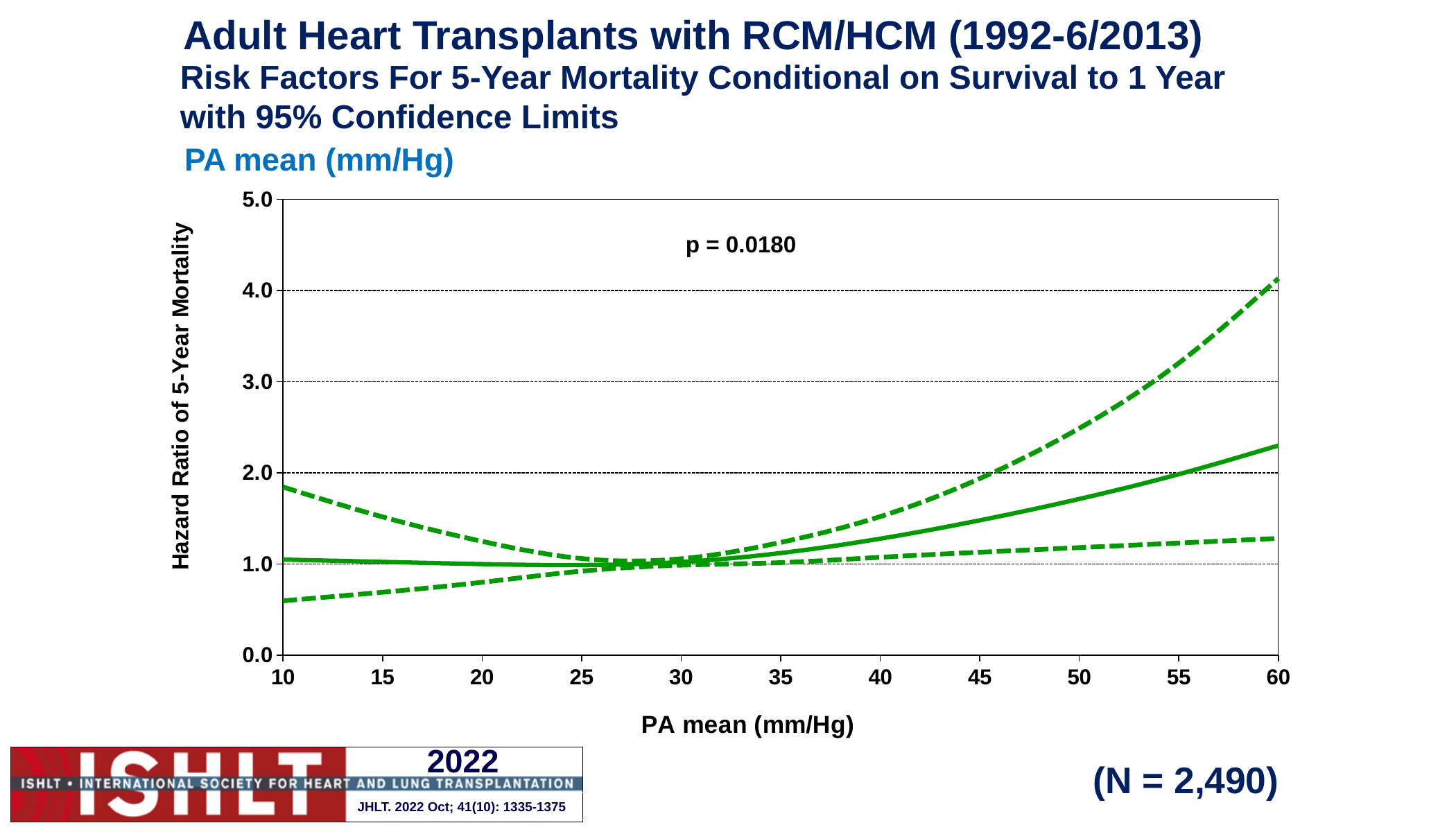
Which is larger on the solid line: the hazard ratio at a PA mean of 60 mm/Hg or at 10 mm/Hg? 60 mm/Hg Is the lower dashed confidence limit at a PA mean of 10 mm/Hg greater or less than 1.0? less Is the upper dashed confidence limit at a PA mean of 10 mm/Hg greater or less than 2.0? less What is the label of the y axis? Hazard Ratio of 5-Year Mortality How many lines are plotted on the chart? 3 What is the highest value shown on the x axis? 60 Is the hazard ratio on the solid line at a PA mean of 60 mm/Hg greater or less than 2.0? greater What kind of chart is shown on the slide? line chart What is the p-value printed on the chart? p = 0.0180 Does the solid hazard ratio line rise or fall as PA mean increases from 30 to 60 mm/Hg? rise